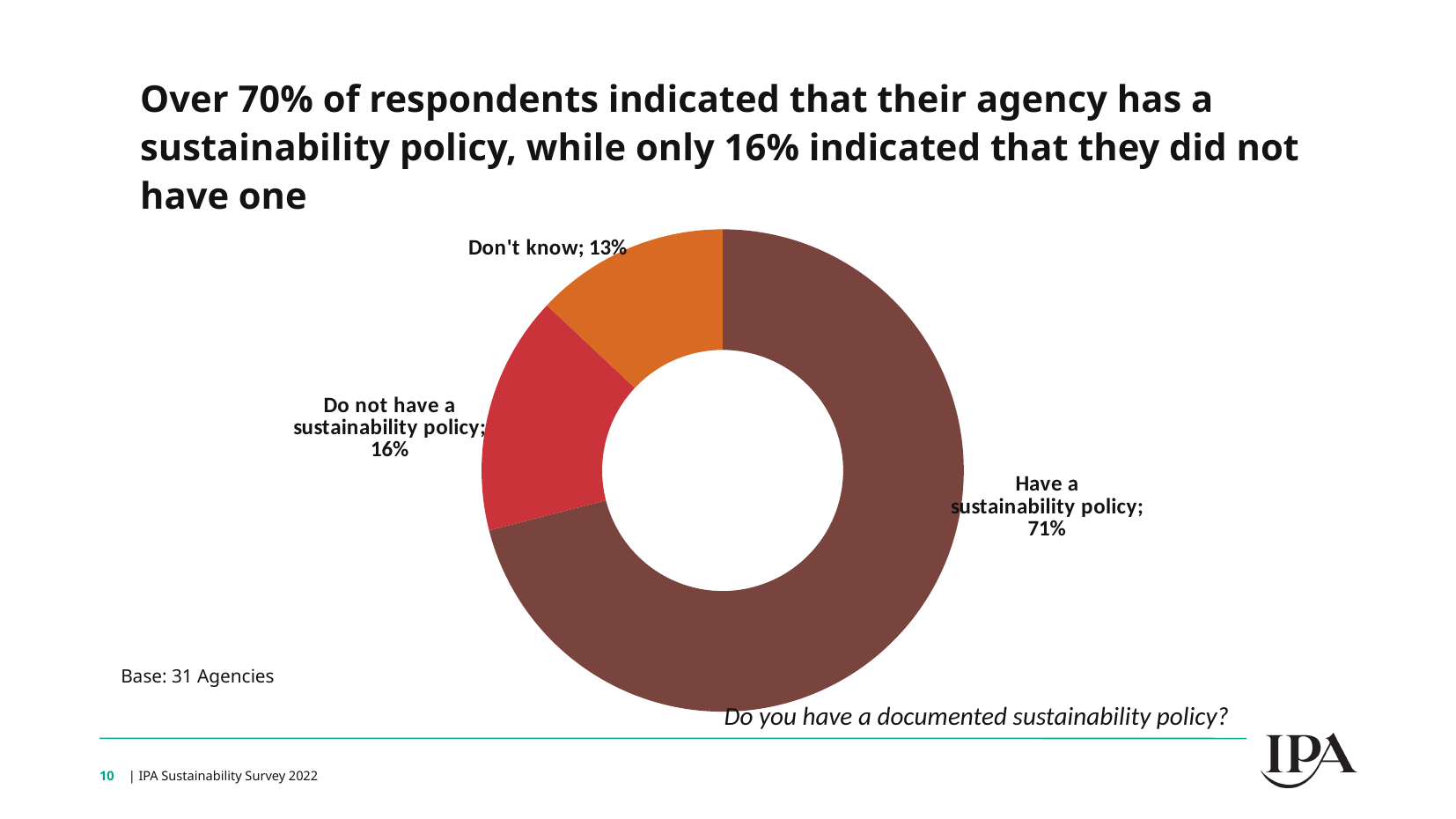
Which category has the smallest share of the chart? Don't know What percentage of respondents do not have a sustainability policy? 16% Which category has the largest share of the chart? Have a sustainability policy How many categories are shown in the chart? 3 What is the difference in percentage points between 'Do not have a sustainability policy' and 'Don't know'? 3 What is the base (number of agencies) stated for the chart? 31 Agencies Which is larger: the share for 'Do not have a sustainability policy' or the share for 'Don't know'? Do not have a sustainability policy What kind of chart is shown on the slide? Pie chart (doughnut) What survey question does the chart relate to, as shown below the chart? Do you have a documented sustainability policy? What percentage of respondents answered 'Don't know'? 13% What percentage of respondents have a sustainability policy? 71% What is the difference in percentage points between 'Have a sustainability policy' and 'Do not have a sustainability policy'? 55